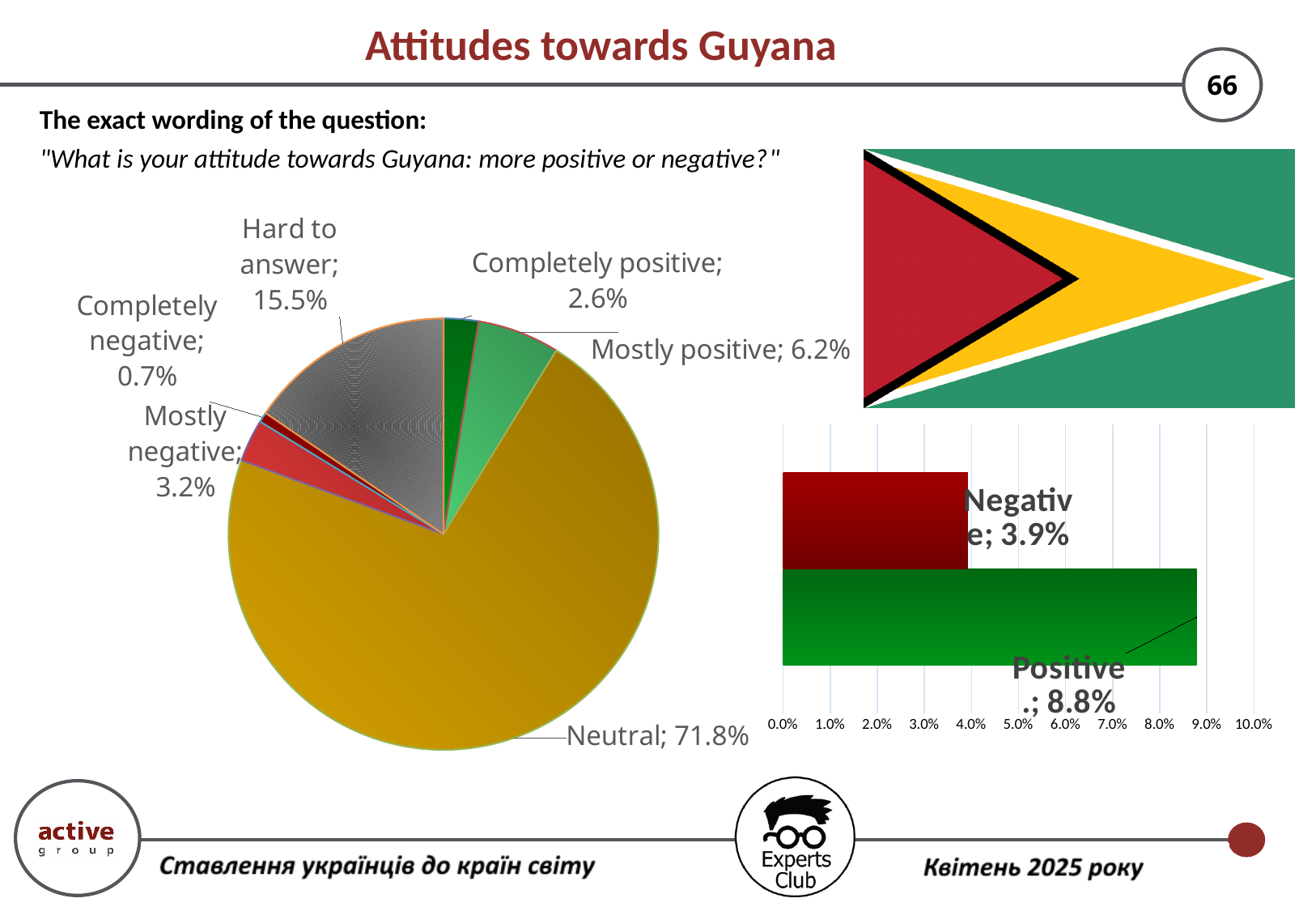
In the pie chart, what is the value for Mostly positive? 6.2% In the pie chart, which is larger: Completely positive or Mostly negative? Mostly negative In the pie chart, what is the difference between Mostly positive and Mostly negative? 3.0% What type of chart is shown on the right side of the slide? Bar chart In the pie chart, what share of respondents answered Neutral? 71.8% In the pie chart, which category has the smallest share? Completely negative In the pie chart, what share of respondents answered Hard to answer? 15.5% In the pie chart, which category has the largest share? Neutral In the pie chart, how many categories are shown? 6 In the pie chart, what is the value for Completely negative? 0.7% In the bar chart on the right, what is the difference between Positive and Negative? 4.9% In the bar chart on the right, what is the value for Positive? 8.8%